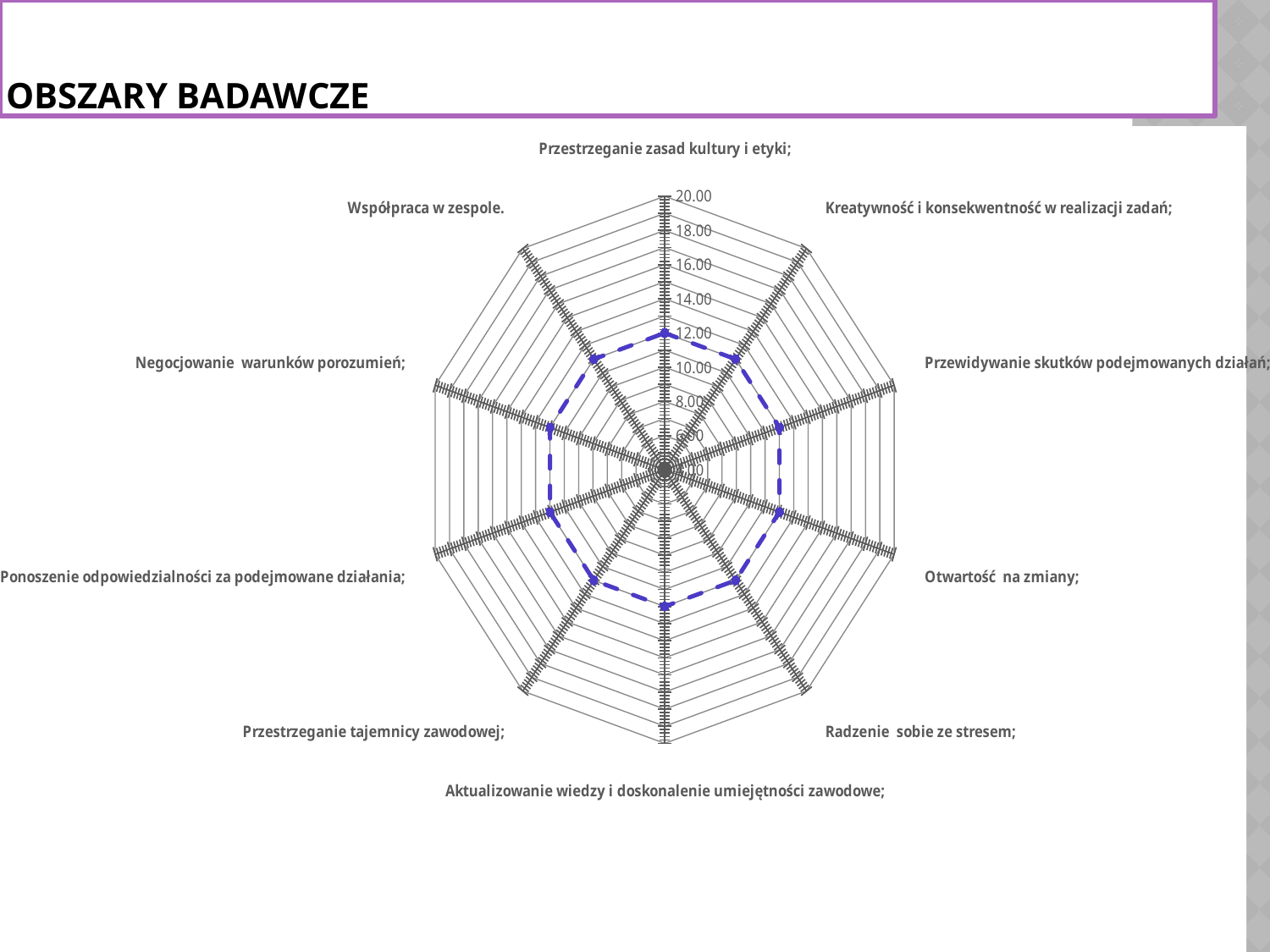
Is the value for 'Otwartość na zmiany' greater or less than 6? greater Is the value for 'Aktualizowanie wiedzy i doskonalenie umiejętności zawodowe' greater or less than 16? less What is the title shown at the top of the slide? OBSZARY BADAWCZE Is the value for 'Przestrzeganie zasad kultury i etyki' greater or less than 16? less How many categories (axes) does the radar chart have? 10 What is the highest value shown on the radar chart's axis scale? 20.00 Which category label appears at the very top of the radar chart? Przestrzeganie zasad kultury i etyki; What kind of chart is shown on the slide? radar chart